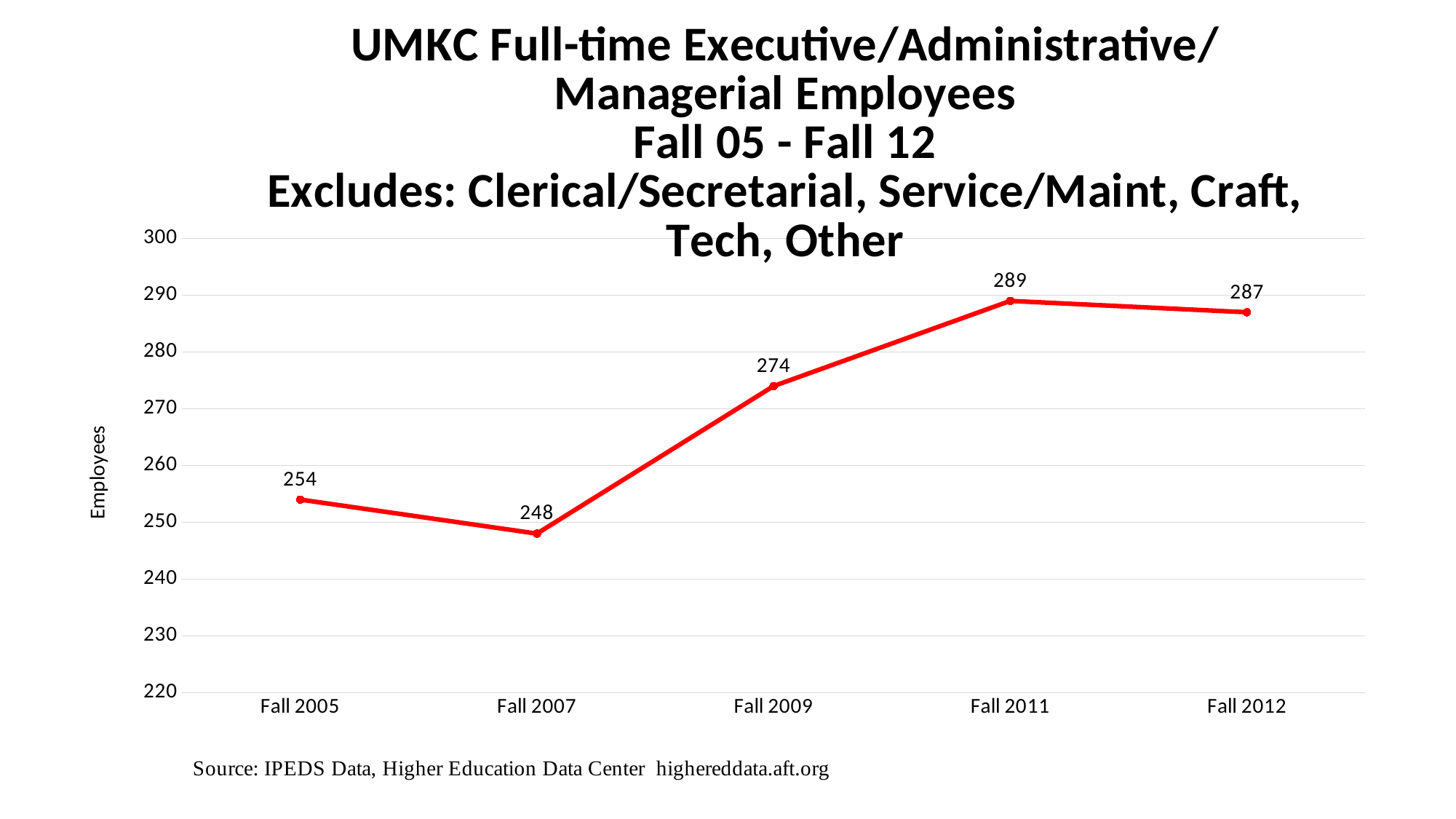
Which period has the lowest number of employees? Fall 2007 What is the number of employees for Fall 2009? 274 What is the number of employees for Fall 2012? 287 What kind of chart is shown on the slide? Line chart How many data points are plotted on the chart? 5 Which has more employees, Fall 2005 or Fall 2007? Fall 2005 Is the value for Fall 2009 greater or less than 270? greater What is the number of employees for Fall 2005? 254 What is the difference in employees between Fall 2009 and Fall 2005? 20 What is the difference in employees between Fall 2011 and Fall 2007? 41 Which period has the highest number of employees? Fall 2011 What is the label on the vertical axis? Employees